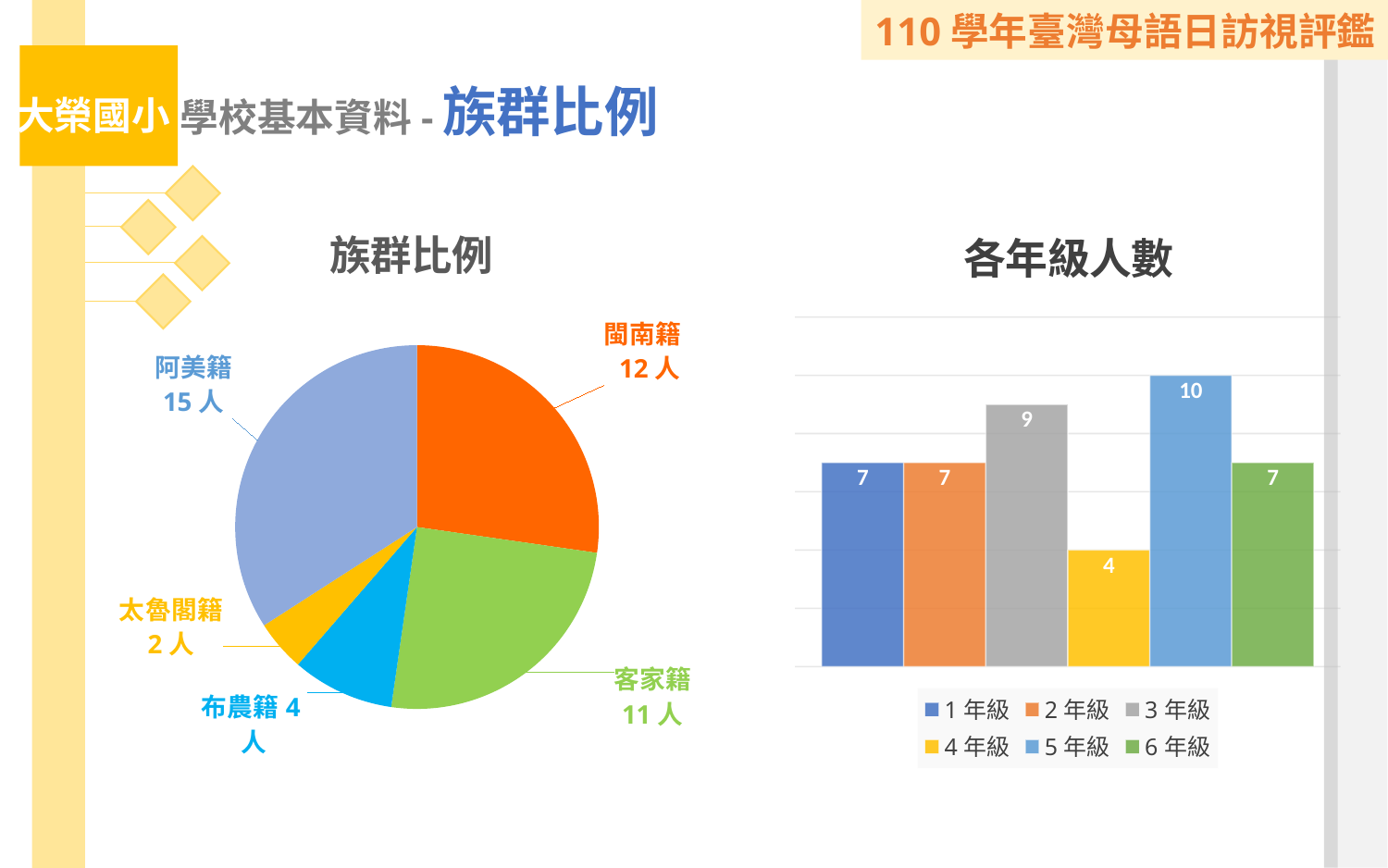
What kind of chart is the 各年級人數 chart? bar chart In the 各年級人數 chart, which grade has the lowest value? 4 年級 In the 族群比例 pie chart, which group has the largest slice? 阿美籍 In the 族群比例 pie chart, how many people are 阿美籍? 15 人 In the 族群比例 pie chart, which group has the smallest slice? 太魯閣籍 In the 族群比例 pie chart, how many people are 太魯閣籍? 2 人 In the 族群比例 pie chart, how many groups are shown? 5 In the 各年級人數 chart, which is larger, 3 年級 or 6 年級? 3 年級 In the 各年級人數 chart, what is the value for 5 年級? 10 In the 族群比例 pie chart, what is the difference between the number of 閩南籍 and 客家籍 people? 1 人 What kind of chart is the 族群比例 chart? pie chart In the 各年級人數 chart, how many series does the legend list? 6